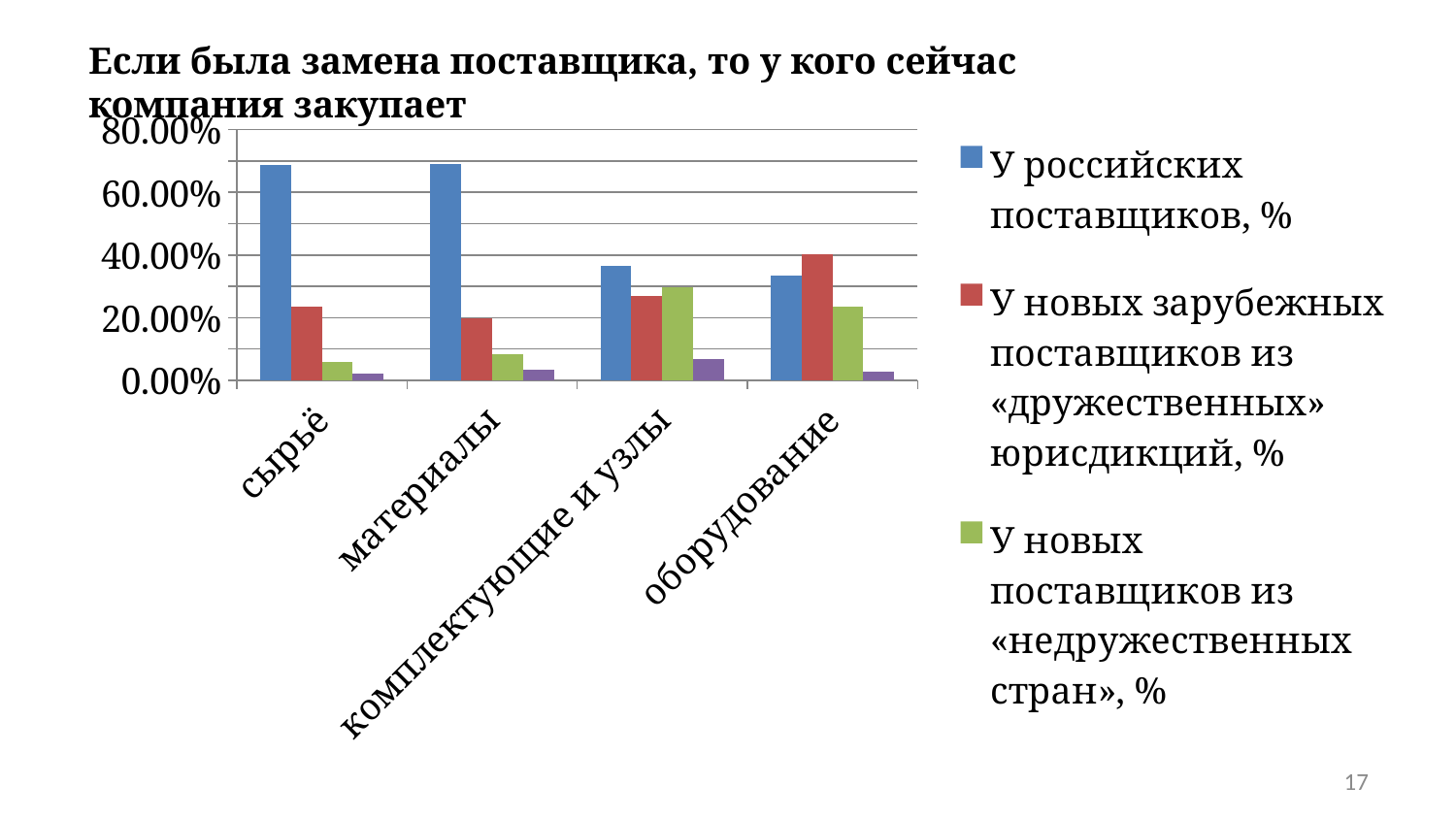
In which category is the value for 'У новых зарубежных поставщиков из «дружественных» юрисдикций, %' the highest? оборудование In the category 'оборудование', which is larger: the value for 'У российских поставщиков, %' or for 'У новых зарубежных поставщиков из «дружественных» юрисдикций, %'? У новых зарубежных поставщиков из «дружественных» юрисдикций, % Is the value for 'У новых зарубежных поставщиков из «дружественных» юрисдикций, %' in the category 'оборудование' greater or less than 20.00%? greater What colour represents the series 'У российских поставщиков, %' in the chart? blue Is the value for 'У российских поставщиков, %' in the category 'сырьё' greater or less than 60.00%? greater How many bars are plotted for each category in the chart? 4 How many categories are shown on the x axis of the chart? 4 In the category 'сырьё', which is larger: the value for 'У российских поставщиков, %' or for 'У новых зарубежных поставщиков из «дружественных» юрисдикций, %'? У российских поставщиков, % Is the value for 'У российских поставщиков, %' in the category 'комплектующие и узлы' greater or less than 40.00%? less What kind of chart is shown on the slide? bar chart In which category is the value for 'У новых поставщиков из «недружественных стран», %' the highest? комплектующие и узлы